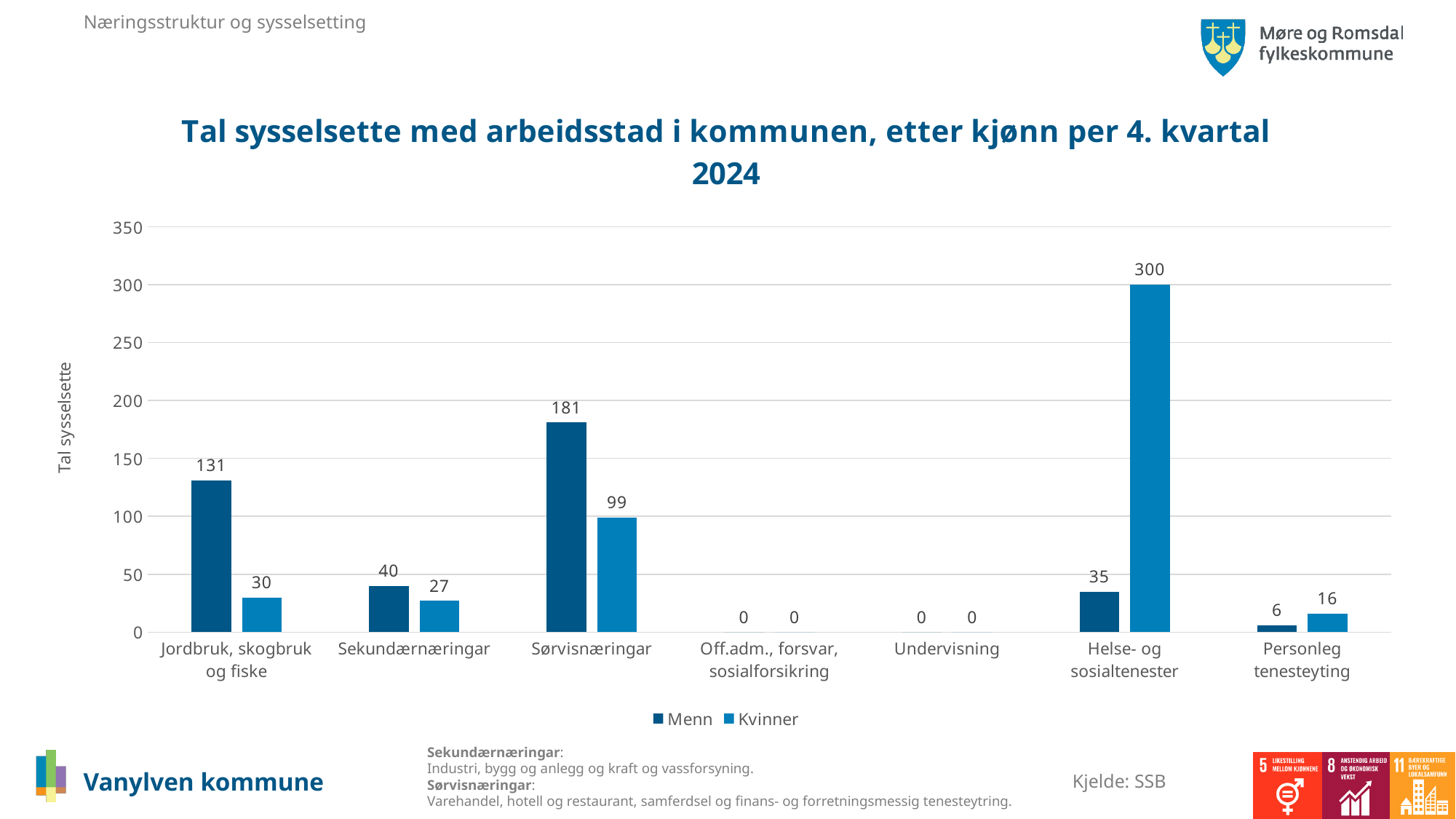
What is the value for Kvinner in Jordbruk, skogbruk og fiske? 30 How many series does the legend list? 2 Which category has the highest value for Menn? Sørvisnæringar What is the value for Kvinner in Helse- og sosialtenester? 300 What is the value for Menn in Sørvisnæringar? 181 What kind of chart is shown on the slide? Bar chart What is the value for Menn in Personleg tenesteyting? 6 Which is larger in Sekundærnæringar, Menn or Kvinner? Menn What is the difference between Kvinner and Menn in Helse- og sosialtenester? 265 How many categories are shown on the x axis? 7 Which category has the highest value for Kvinner? Helse- og sosialtenester What is the difference between Menn and Kvinner in Sørvisnæringar? 82